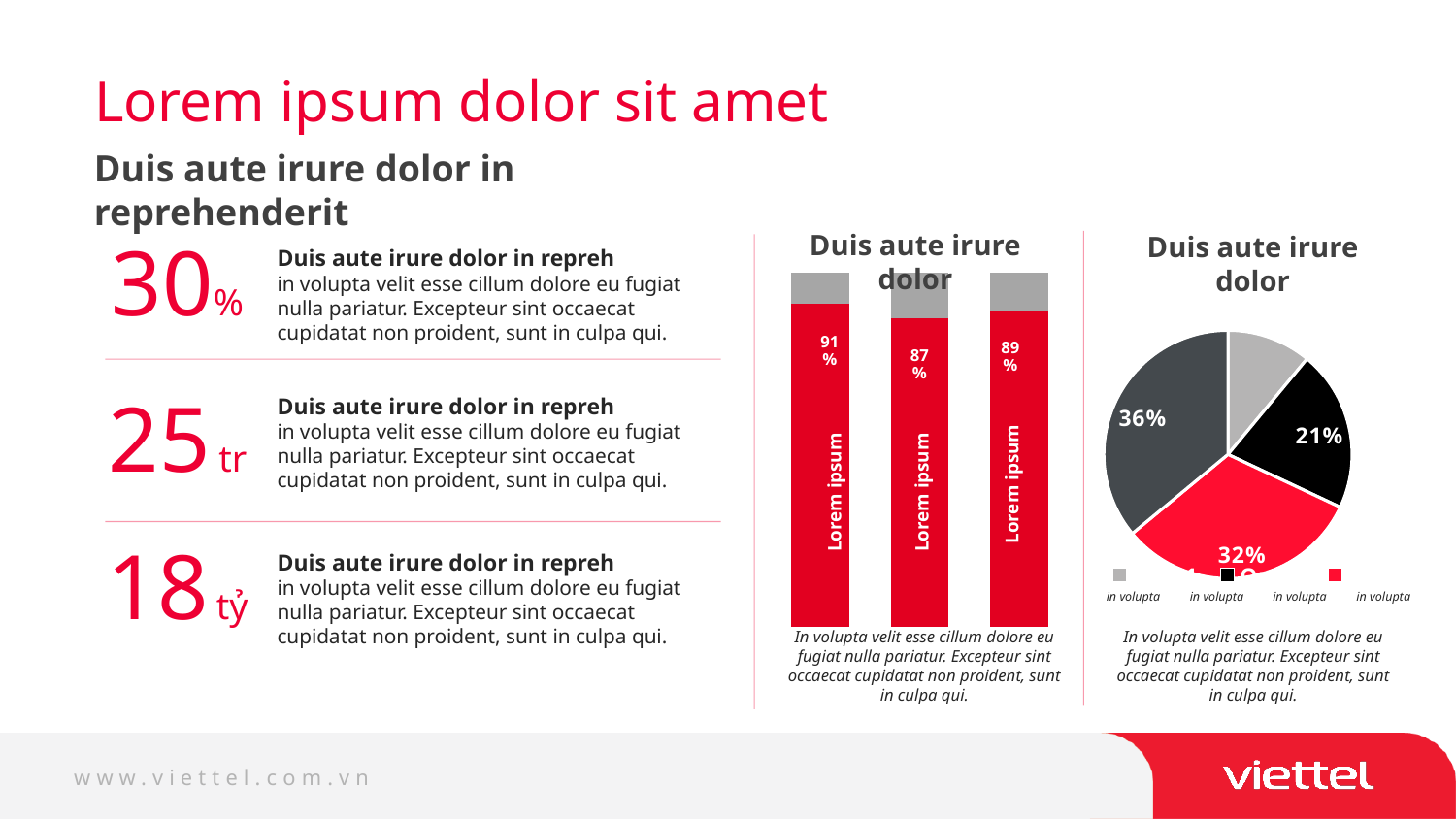
What kind of chart is the chart in the middle of the slide? bar chart In the bar chart in the middle of the slide, what value is printed on the right-most bar? 89% What kind of chart is the chart on the right of the slide? pie chart In the pie chart on the right of the slide, what share does the dark grey slice have? 36% How many entries does the legend of the pie chart on the right of the slide list? 4 In the bar chart in the middle of the slide, what value is printed on the left-most bar? 91% In the pie chart on the right of the slide, which is larger, the red slice or the black slice? the red slice (32%) In the bar chart in the middle of the slide, which bar has the lowest printed value? the middle bar (87%) In the pie chart on the right of the slide, what is the difference between the dark grey slice and the red slice? 4 percentage points In the bar chart in the middle of the slide, what value is printed on the middle bar? 87% In the bar chart in the middle of the slide, what is the difference between the highest and lowest printed values? 4 percentage points How many bars does the bar chart in the middle of the slide have? 3